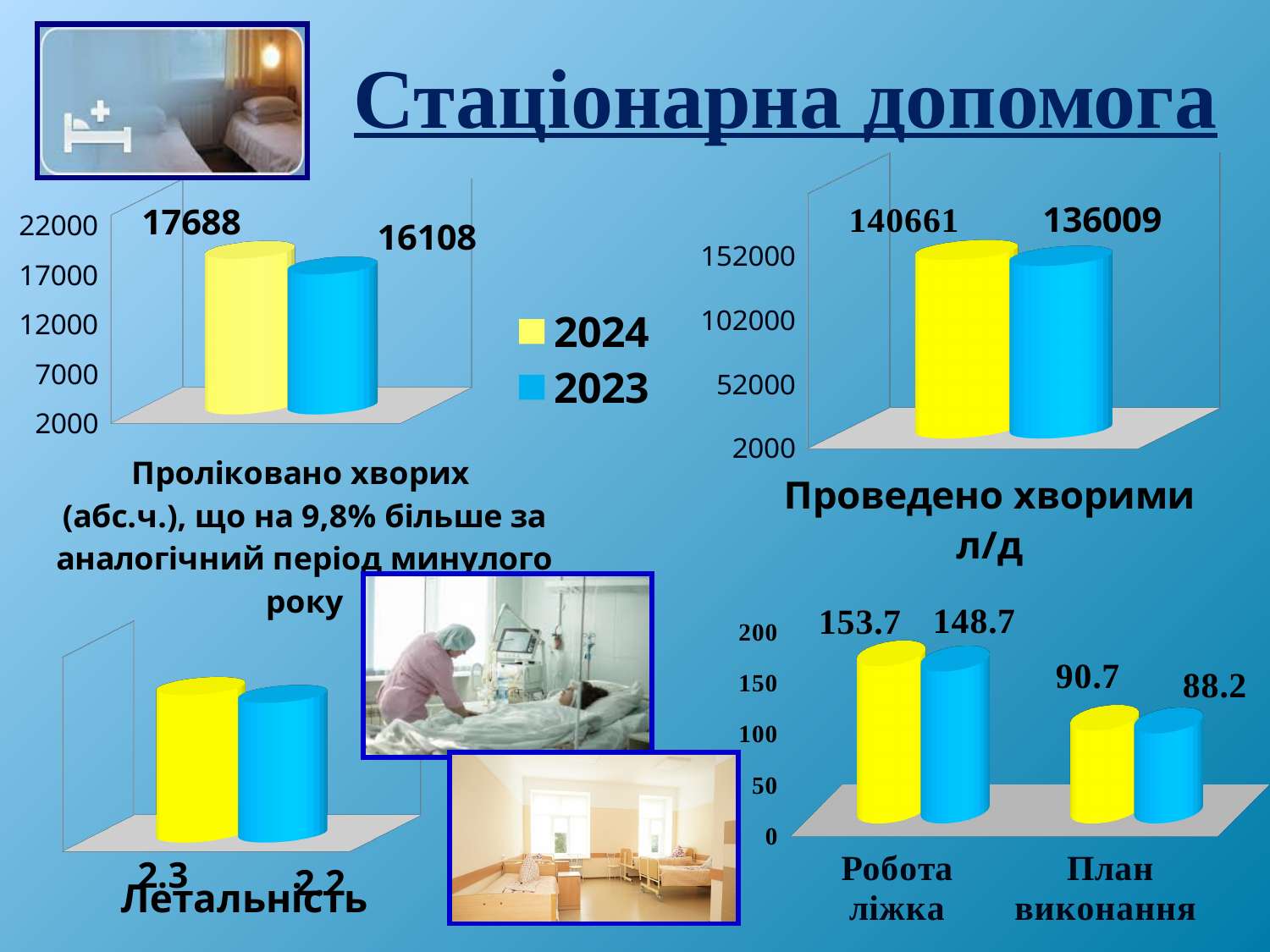
In the top-left chart (Проліковано хворих), what is the value for 2024? 17688 In the top-right chart (Проведено хворими л/д), what is the difference between the 2024 and 2023 values? 4652 In the bottom-right chart, is the 2024 value for План виконання greater or less than 100? less What kind of chart is the top-left chart (Проліковано хворих)? bar chart In the top-right chart (Проведено хворими л/д), what is the value for 2024? 140661 In the top-left chart (Проліковано хворих), what is the value for 2023? 16108 In the bottom-left chart (Летальність), what is the value for 2023? 2.2 How many series does the legend on the slide list? 2 In the top-right chart (Проведено хворими л/д), which year has the larger value, 2024 or 2023? 2024 In the bottom-right chart, what is the 2024 value for Робота ліжка? 153.7 In the bottom-right chart, what is the 2023 value for План виконання? 88.2 In the top-left chart (Проліковано хворих), what is the difference between the 2024 and 2023 values? 1580